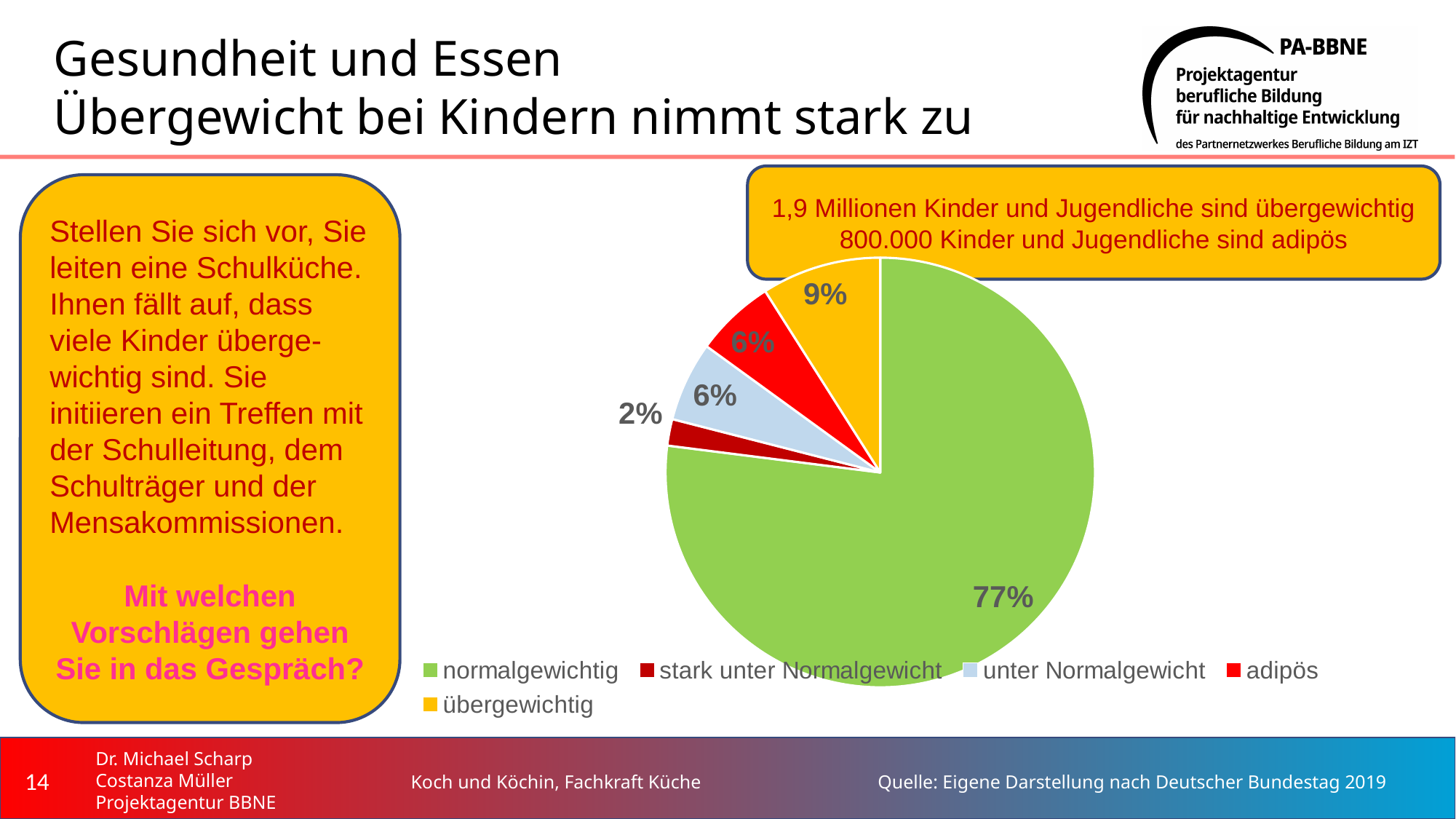
What is the value shown for 'stark unter Normalgewicht' in the pie chart? 2% Which is larger in the pie chart, 'übergewichtig' or 'adipös'? übergewichtig What is the value shown for 'unter Normalgewicht' in the pie chart? 6% Which category has the smallest slice in the pie chart? stark unter Normalgewicht What is the value shown for 'übergewichtig' in the pie chart? 9% How many slices does the pie chart have? 5 What share of the pie chart is labelled 'normalgewichtig'? 77% What is the value shown for 'adipös' in the pie chart? 6% What kind of chart is shown on the slide? pie chart Which category has the largest slice in the pie chart? normalgewichtig How many entries does the legend of the pie chart list? 5 What is the difference in percentage points between 'normalgewichtig' and 'übergewichtig' in the pie chart? 68